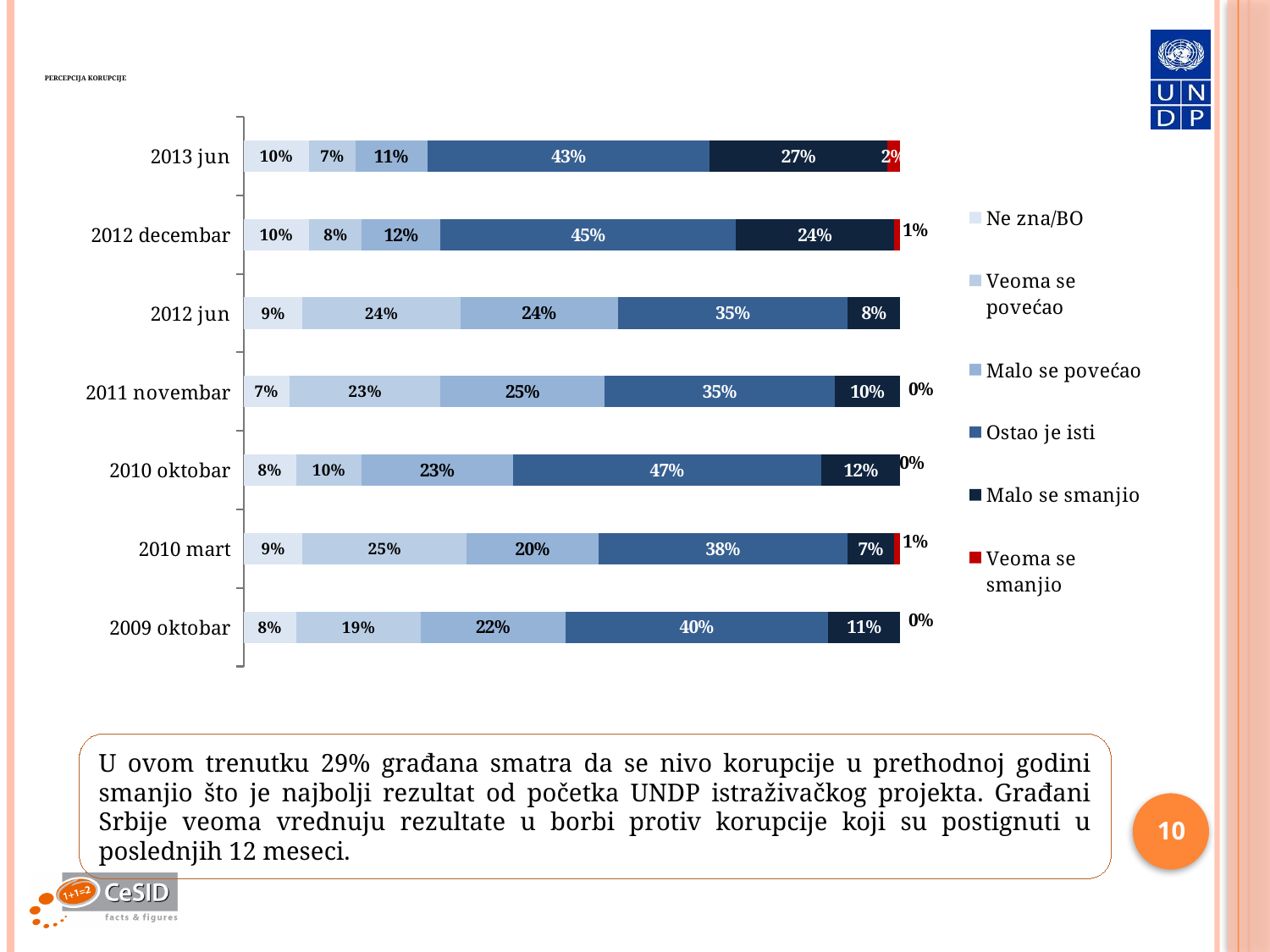
In which survey period is the 'Malo se smanjio' value lowest? 2010 mart What kind of chart is shown on the slide? Stacked bar chart What is the total of the stacked bar for 2013 jun? 100% Which legend entry is shown in red? Veoma se smanjio What is the difference between the 'Malo se smanjio' values for 2013 jun and 2012 jun? 19% How many survey periods (categories) are shown on the chart? 7 How many series does the legend list? 6 In which survey period is the 'Ostao je isti' value highest? 2010 oktobar Which is larger: the 'Veoma se povećao' value for 2011 novembar or for 2013 jun? 2011 novembar What is the value for 'Malo se smanjio' in 2012 decembar? 24% What is the value for 'Ostao je isti' in 2013 jun? 43% What is the value for 'Veoma se povećao' in 2010 mart? 25%